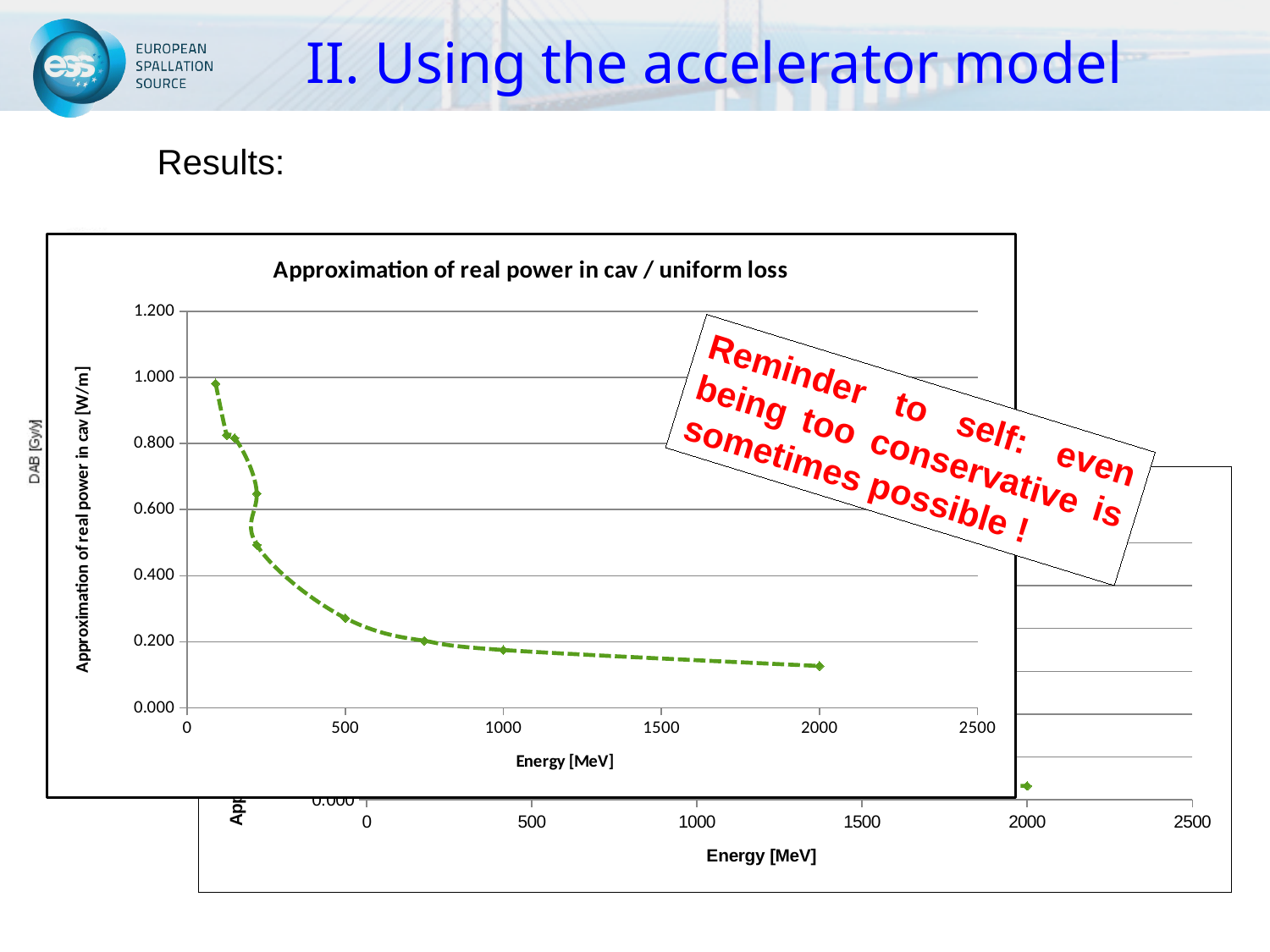
In the chart 'Approximation of real power in cav / uniform loss', is the value at 500 MeV greater or less than 0.400? less In the chart 'Approximation of real power in cav / uniform loss', is the highest plotted value greater or less than 0.800? greater In the chart 'Approximation of real power in cav / uniform loss', does the plotted value rise or fall as energy increases along the x axis? fall In the chart 'Approximation of real power in cav / uniform loss', is the value at 500 MeV greater or less than 0.200? greater What kind of chart is 'Approximation of real power in cav / uniform loss'? line chart What is the x-axis label of the chart 'Approximation of real power in cav / uniform loss'? Energy [MeV] In the chart 'Approximation of real power in cav / uniform loss', which is larger: the value at 500 MeV or the value at 2000 MeV? 500 MeV In the chart 'Approximation of real power in cav / uniform loss', at which end of the energy range is the plotted value lowest: the lowest energy or the highest energy (2000 MeV)? 2000 MeV What is the y-axis label of the chart 'Approximation of real power in cav / uniform loss'? Approximation of real power in cav [W/m]